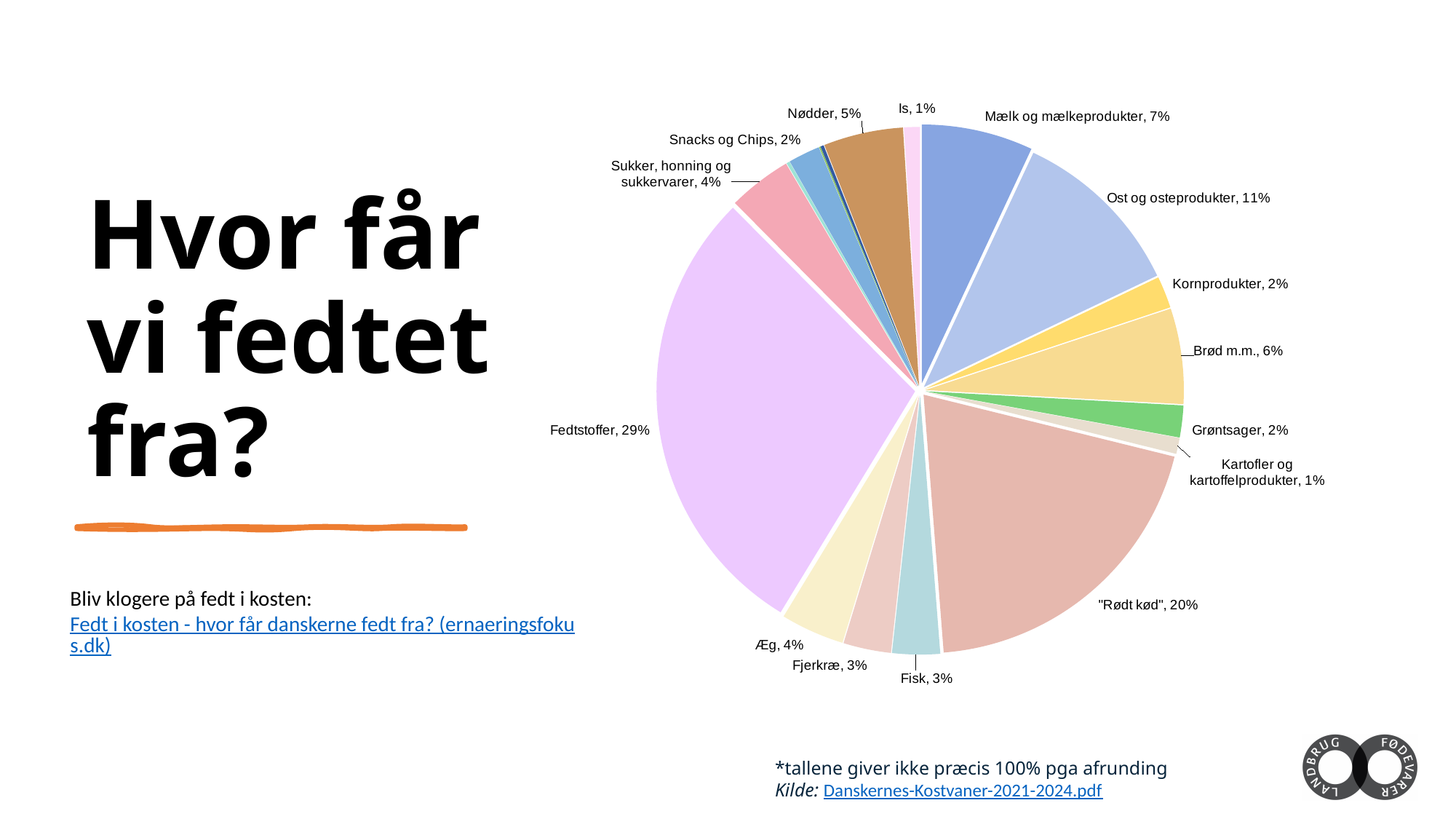
What is the difference in percentage points between Ost og osteprodukter and Mælk og mælkeprodukter? 4 What share of fat comes from Fedtstoffer? 29% What percentage is shown for Nødder? 5% What percentage is shown for "Rødt kød"? 20% What is the combined share of Fisk and Fjerkræ? 6% What percentage is shown for Ost og osteprodukter? 11% What is the title of the slide containing the pie chart? Hvor får vi fedtet fra? Which is larger, Mælk og mælkeprodukter or Brød m.m.? Mælk og mælkeprodukter What kind of chart is shown on the slide? pie chart What percentage is shown for Kartofler og kartoffelprodukter? 1% Which category has the largest slice of the pie? Fedtstoffer What is the difference in percentage points between Fedtstoffer and "Rødt kød"? 9